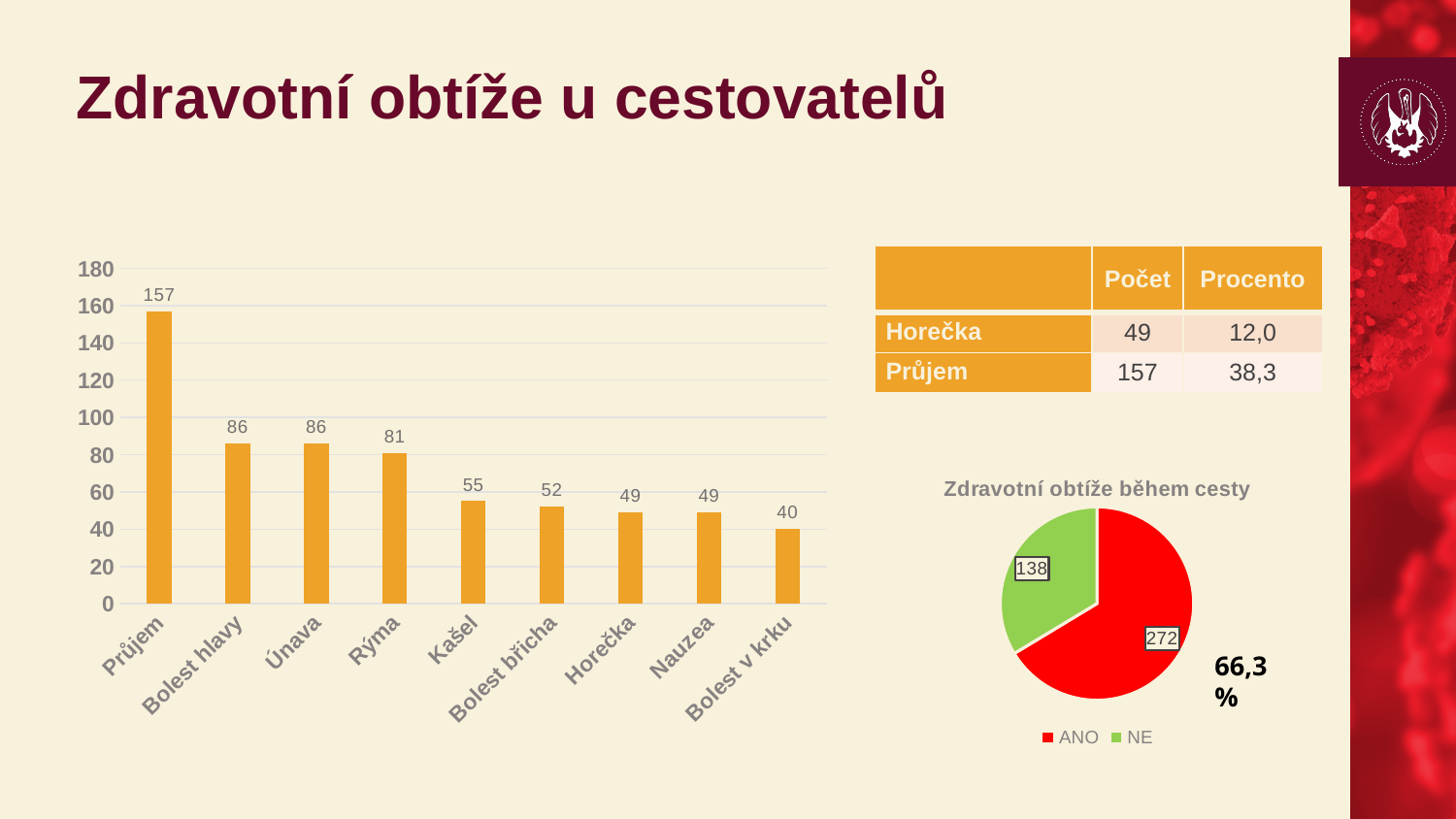
In the bar chart on the left, what is the difference between the values for Průjem and Rýma? 76 How many entries does the legend of the pie chart titled 'Zdravotní obtíže během cesty' list? 2 In the bar chart on the left, what is the value for Bolest v krku? 40 What kind of chart is the chart on the left of the slide? Bar chart In the bar chart on the left, what is the value for Průjem? 157 In the pie chart titled 'Zdravotní obtíže během cesty', what is the value for ANO? 272 In the bar chart on the left, what is the value for Kašel? 55 In the bar chart on the left, which is larger, the value for Bolest břicha or the value for Horečka? Bolest břicha In the bar chart on the left, which category has the lowest value? Bolest v krku In the pie chart titled 'Zdravotní obtíže během cesty', what is the total of the ANO and NE slices? 410 In the bar chart on the left, which category has the highest value? Průjem In the bar chart on the left, how many categories are shown? 9